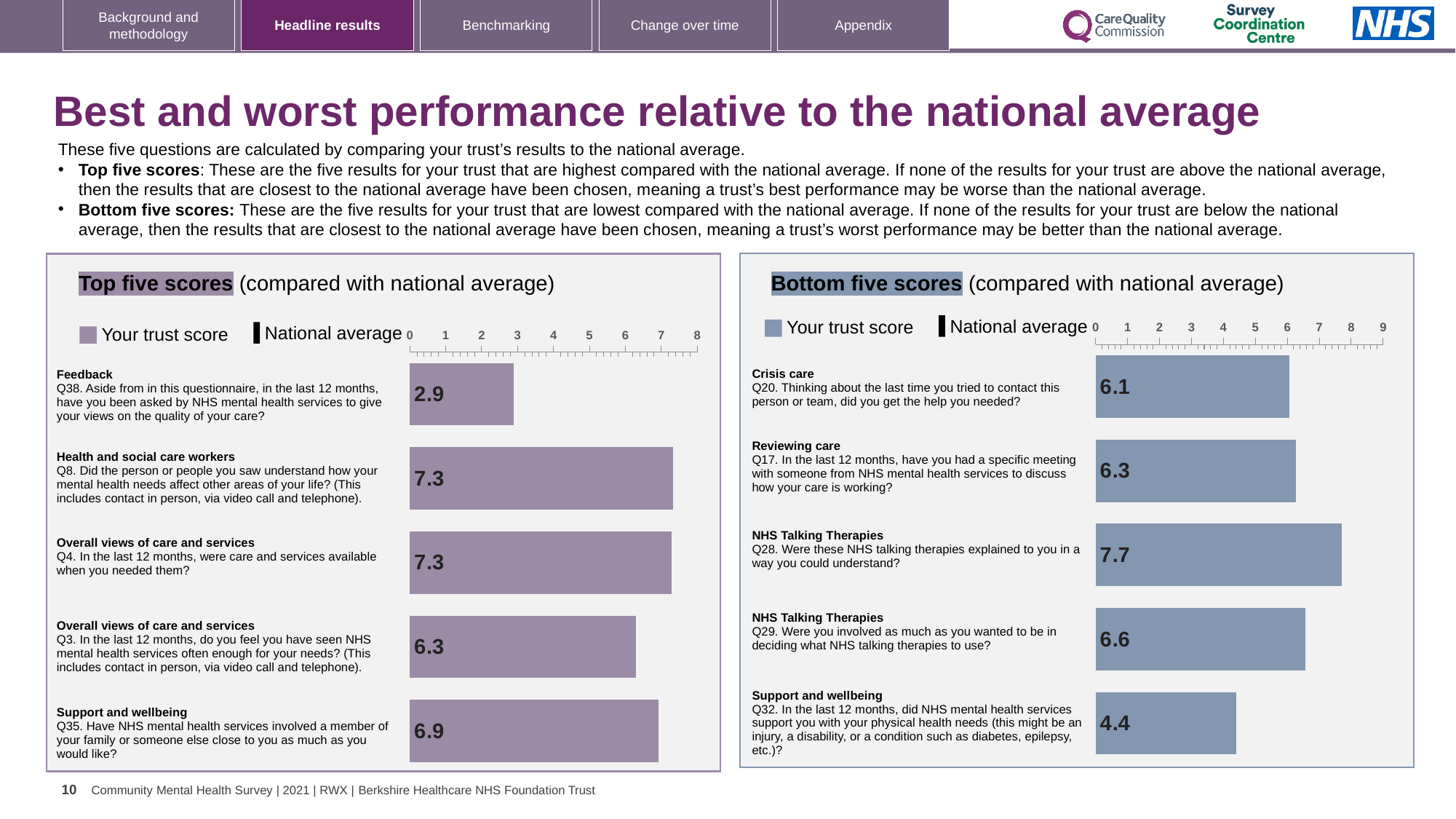
In the Bottom five scores chart, which question has the highest trust score? Q28 (NHS Talking Therapies), 7.7 In the Top five scores chart, is the trust score for Q8 greater or less than 5? greater In the Top five scores chart, what is the difference between the trust scores for Q35 and Q3? 0.6 What type of chart is used for the Bottom five scores? Bar chart In the Bottom five scores chart, what is the trust score for Q29 (NHS Talking Therapies)? 6.6 In the Bottom five scores chart, which question has the lowest trust score? Q32 (Support and wellbeing), 4.4 How many bars are shown in the Top five scores chart? 5 In the Bottom five scores chart, what is the difference between the trust scores for Q28 and Q32? 3.3 In the Bottom five scores chart, what is the trust score for Q32 (Support and wellbeing)? 4.4 In the Top five scores chart, which question has the lowest trust score? Q38 (Feedback), 2.9 In the Bottom five scores chart, which has the larger trust score, Q20 (Crisis care) or Q17 (Reviewing care)? Q17 (Reviewing care) In the Top five scores chart, what is the trust score for Q38 (Feedback)? 2.9